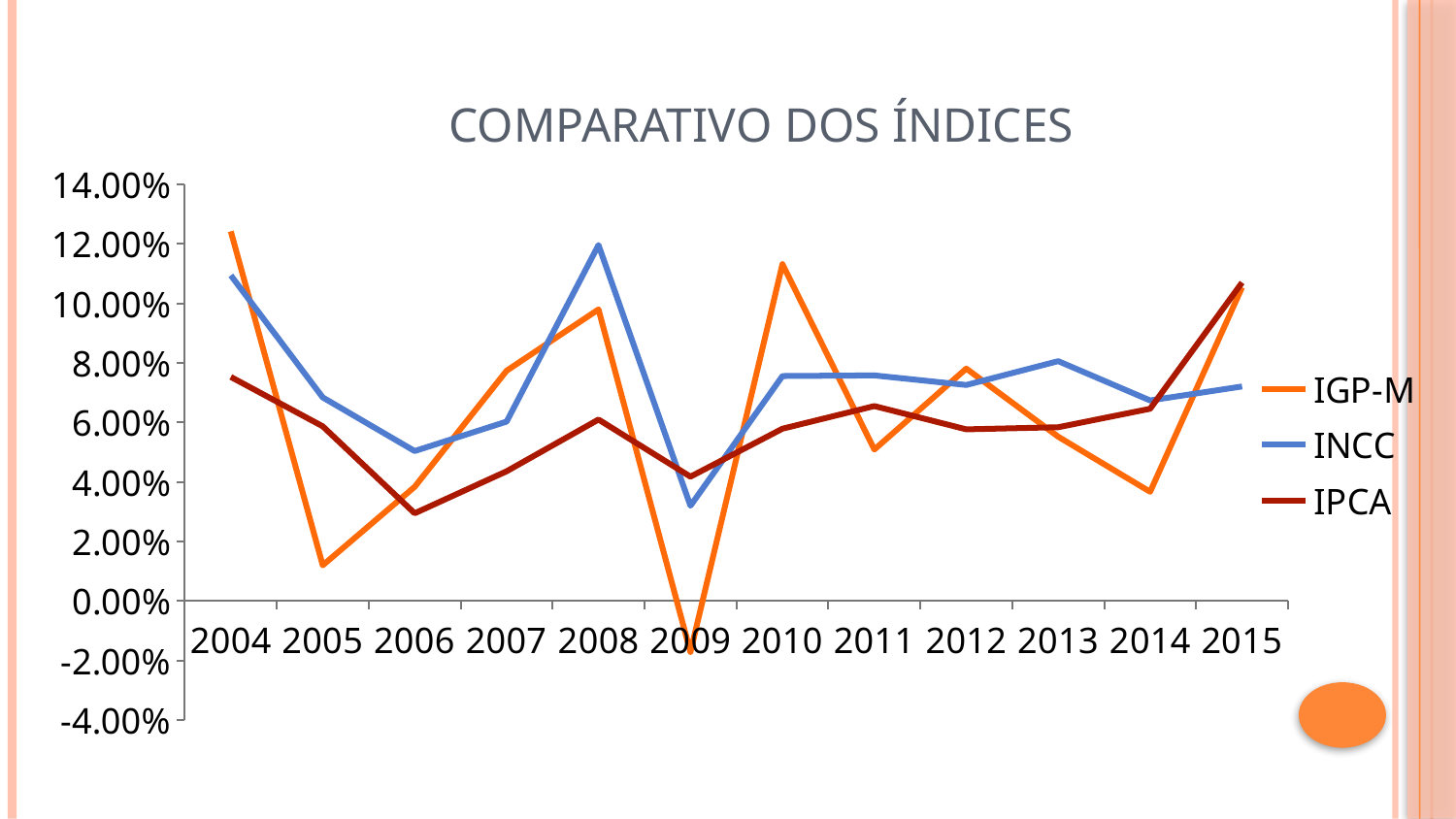
Is the IGP-M value for 2009 greater or less than 0.00%? less In which year does the INCC series reach its highest value? 2008 Is the IGP-M value for 2005 greater or less than 2.00%? less What is the title of the chart? COMPARATIVO DOS ÍNDICES In 2009, which series has the higher value, INCC or IPCA? IPCA In 2010, which series has the higher value, IGP-M or INCC? IGP-M Is the INCC value for 2008 greater or less than 10.00%? greater What type of chart is shown on the slide? Line chart How many series does the legend list? 3 In which year does the IGP-M series reach its highest value? 2004 In which year does the IGP-M series reach its lowest value? 2009 How many years are shown on the x axis? 12